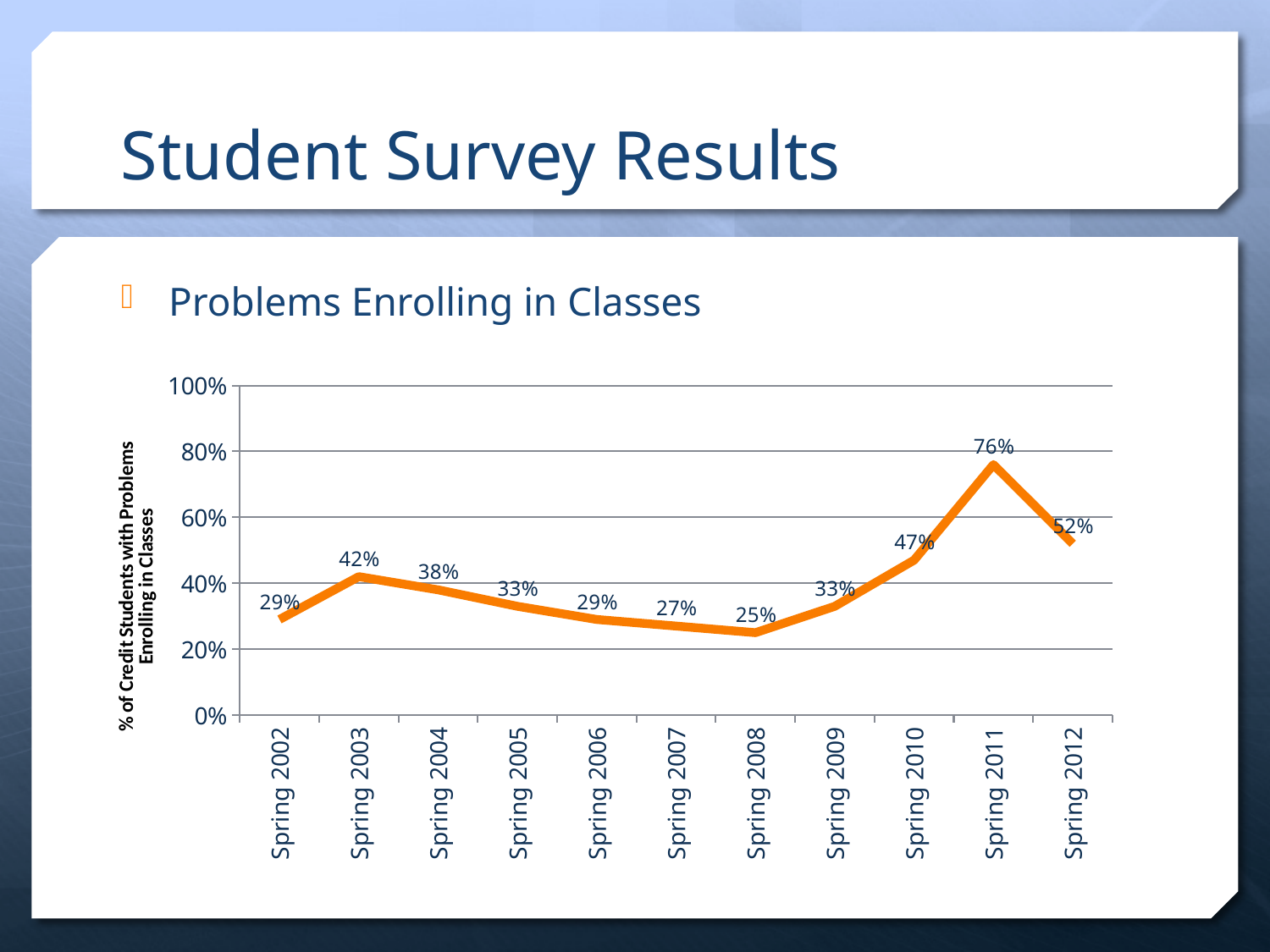
What kind of chart is shown on the slide? Line chart Which year has the lowest percentage of credit students with problems enrolling in classes? Spring 2008 What is the value for Spring 2011? 76% What is the value for Spring 2012? 52% Which is larger, the value for Spring 2003 or the value for Spring 2010? Spring 2010 What is the difference between the values for Spring 2011 and Spring 2012? 24% What is the label on the vertical axis of the chart? % of Credit Students with Problems Enrolling in Classes How many data points are plotted on the chart? 11 What is the value for Spring 2002? 29% What is the value for Spring 2008? 25% Is the value for Spring 2011 greater or less than 60%? greater Which year has the highest percentage of credit students with problems enrolling in classes? Spring 2011